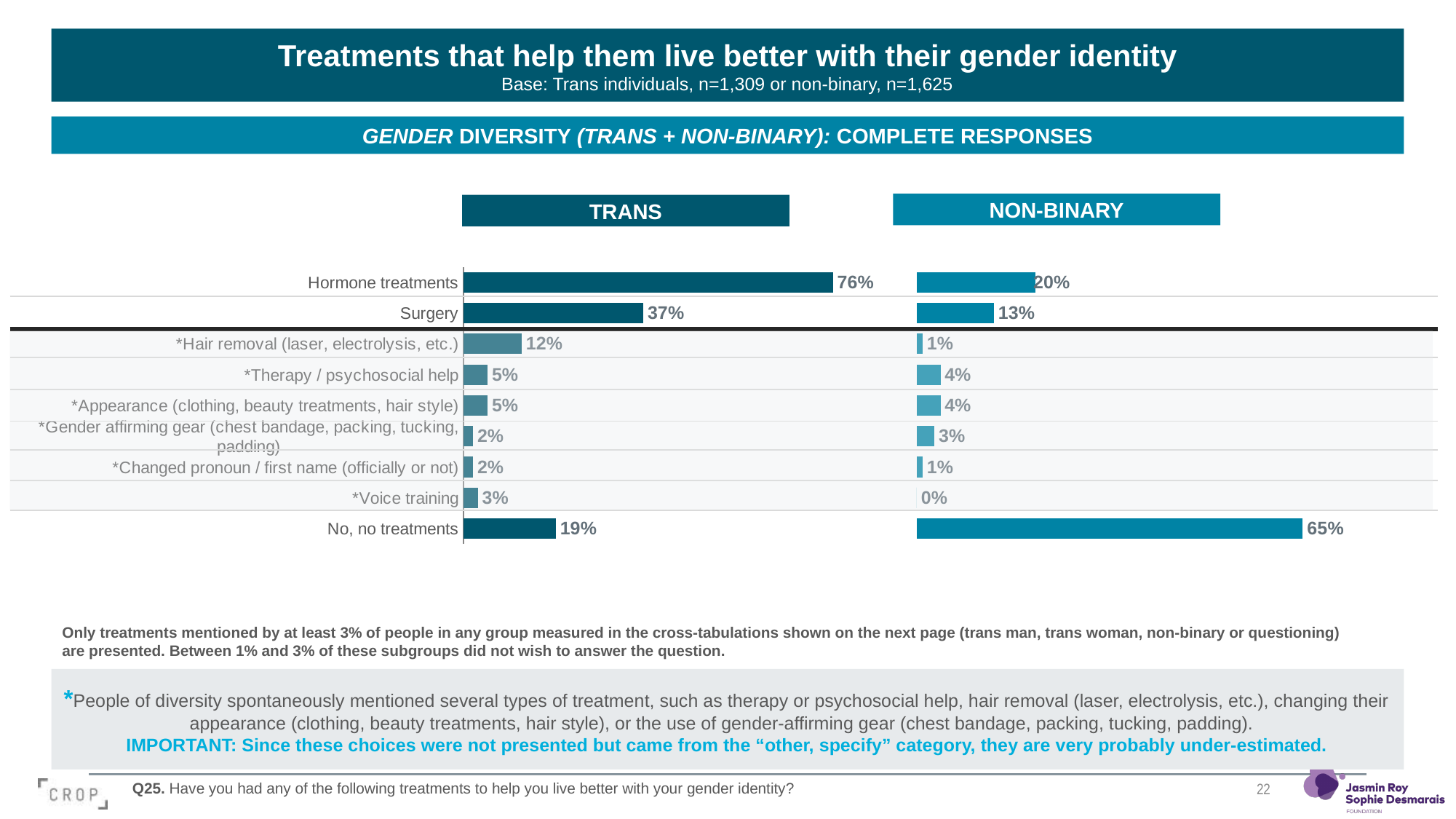
What is the difference between the TRANS and NON-BINARY values for surgery? 24 percentage points Which group has the larger value for 'No, no treatments', TRANS or NON-BINARY? NON-BINARY What is the title of the slide's chart? Treatments that help them live better with their gender identity In the NON-BINARY chart, what percentage reported surgery? 13% What type of chart is used on this slide? Bar chart In the NON-BINARY chart, which category has the lowest value? *Voice training How many categories are listed in the charts? 9 What is the difference between the TRANS and NON-BINARY values for hormone treatments? 56 percentage points In the TRANS chart, what percentage reported hair removal (laser, electrolysis, etc.)? 12% In the TRANS chart, what percentage reported hormone treatments? 76% In the NON-BINARY chart, what percentage reported no treatments? 65% In the TRANS chart, which treatment category has the highest value? Hormone treatments